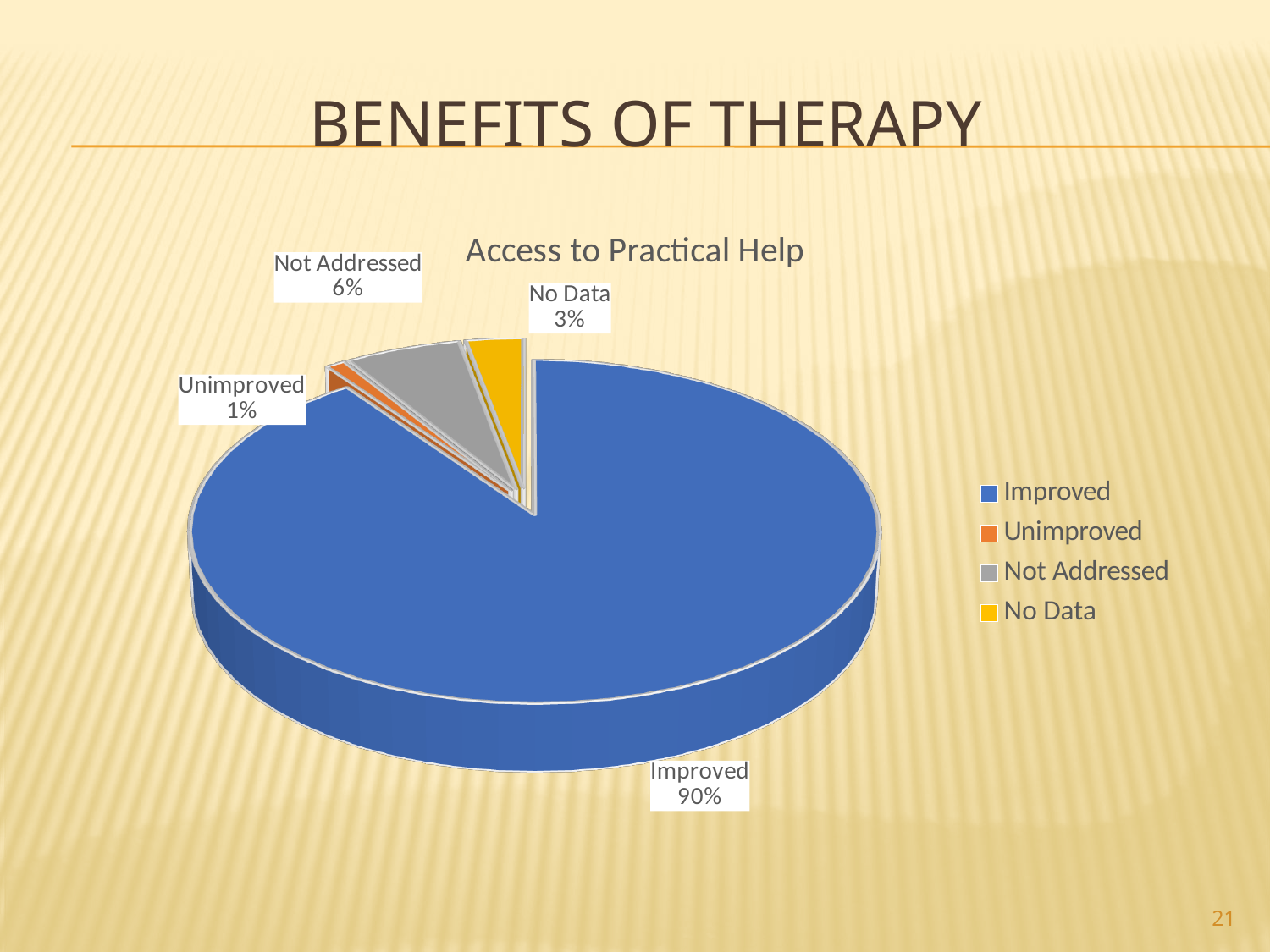
What share of the pie is labelled Improved? 90% What share of the pie is labelled No Data? 3% What colour is the Improved slice? Blue How many categories does the legend list? 4 Which is larger, the Not Addressed slice or the No Data slice? Not Addressed Which category has the smallest slice of the pie? Unimproved What share of the pie is labelled Unimproved? 1% Which category has the largest slice of the pie? Improved What kind of chart is shown on the slide? Pie chart What is the title of the chart? Access to Practical Help What is the difference in percentage points between Not Addressed and No Data? 3%